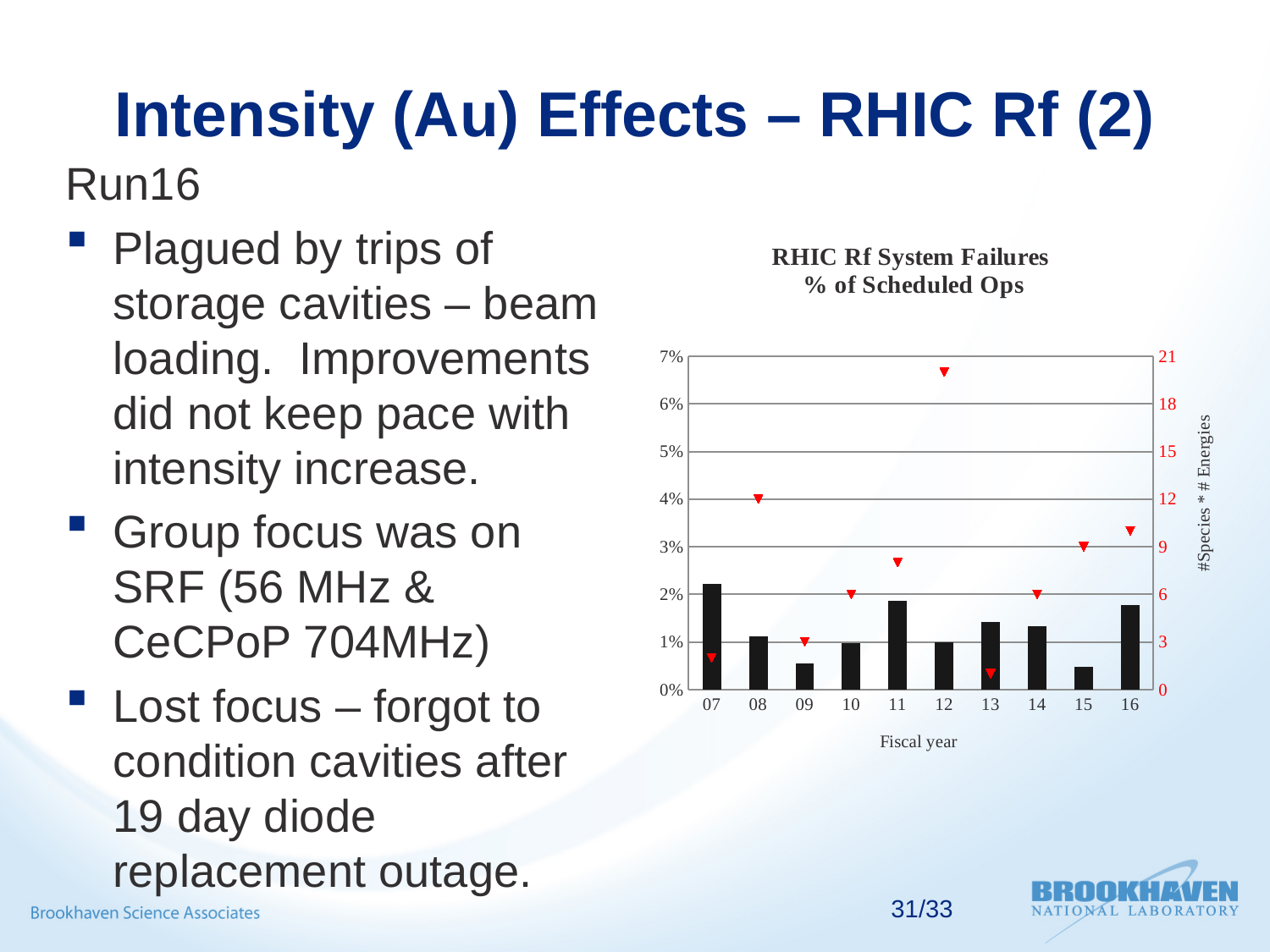
How many fiscal years are plotted on the x axis of the chart? 10 Which fiscal year has the taller bar, 07 or 08? 07 What kind of chart is shown on the slide? bar chart Is the bar value for fiscal year 07 greater or less than 2%? greater What is the label of the x axis of the chart? Fiscal year Which fiscal year has the taller bar, 16 or 15? 16 Is the bar value for fiscal year 11 greater or less than 2%? less What is the title of the chart? RHIC Rf System Failures % of Scheduled Ops Which fiscal year has the highest red triangle marker (#Species * # Energies) in the chart? 12 Is the red triangle marker value for fiscal year 12 greater or less than 18 on the right axis? greater Which fiscal year has the tallest bar in the chart? 07